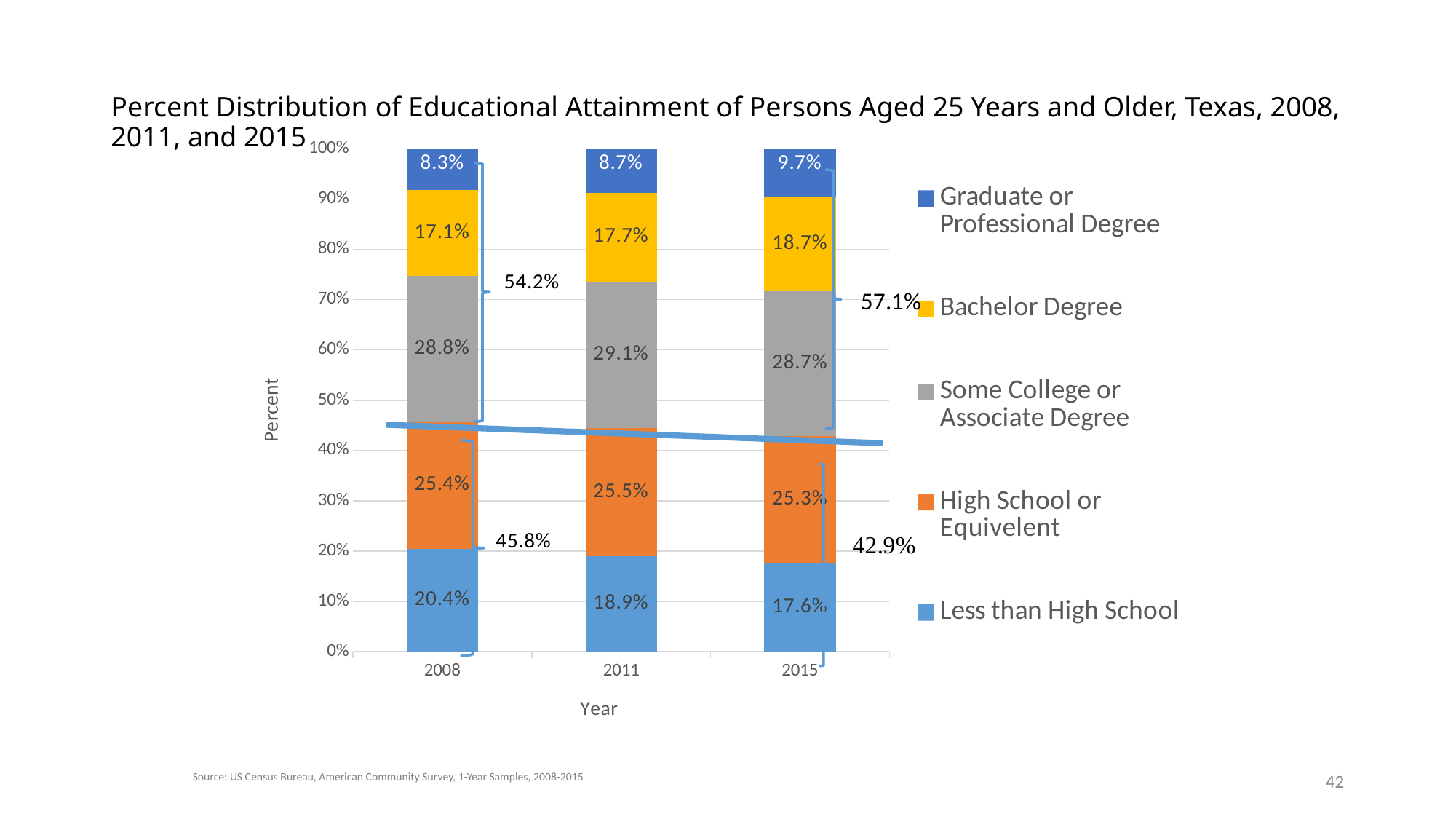
What is the value for Bachelor Degree in 2015? 18.7% In which year is the Less than High School share the lowest? 2015 By how many percentage points did the Less than High School share fall from 2008 to 2015? 2.8 percentage points What is the value for Graduate or Professional Degree in 2011? 8.7% Does the Bachelor Degree share rise or fall from 2008 to 2015? Rises What percentage of persons aged 25 and older in Texas had less than a high school education in 2008? 20.4% In which year is the Graduate or Professional Degree share the highest? 2015 How many educational attainment categories does the legend list? 5 What combined percentage does the bracket annotation show for the top three categories (Some College or Associate Degree, Bachelor Degree, and Graduate or Professional Degree) in 2008? 54.2% What kind of chart is shown on the slide? Stacked bar chart How many years are shown on the x axis? 3 Which year has the larger Some College or Associate Degree share, 2011 or 2015? 2011